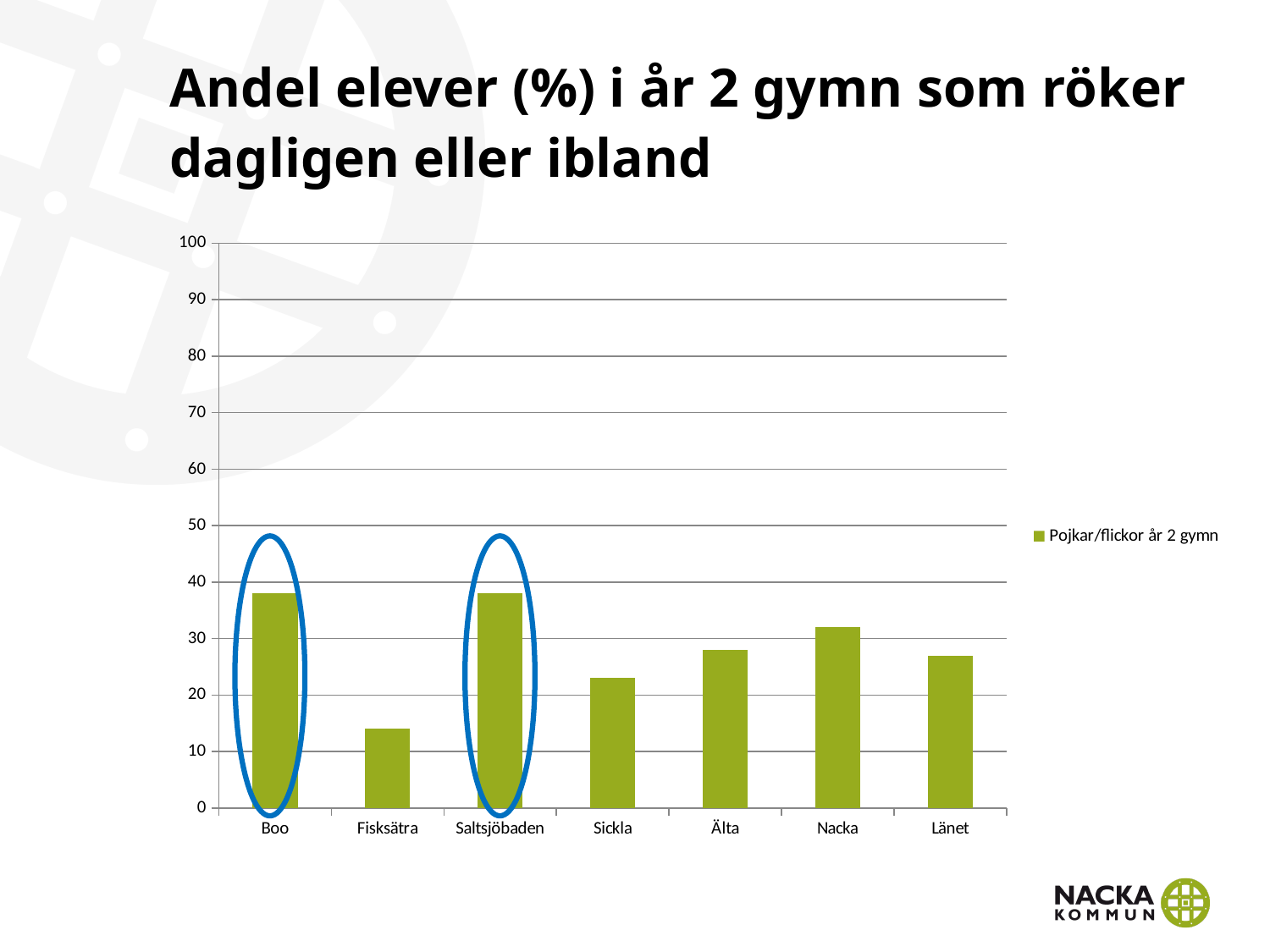
Which has a larger value, Fisksätra or Länet? Länet Is the value for Boo greater or less than 30? greater Which category has the lowest value in the chart? Fisksätra What kind of chart is shown on the slide? bar chart Is the value for Nacka greater or less than 30? greater How many categories are shown on the x axis of the chart? 7 Is the value for Fisksätra greater or less than 20? less What is the name of the series listed in the legend? Pojkar/flickor år 2 gymn Which has a larger value, Nacka or Sickla? Nacka How many series does the legend list? 1